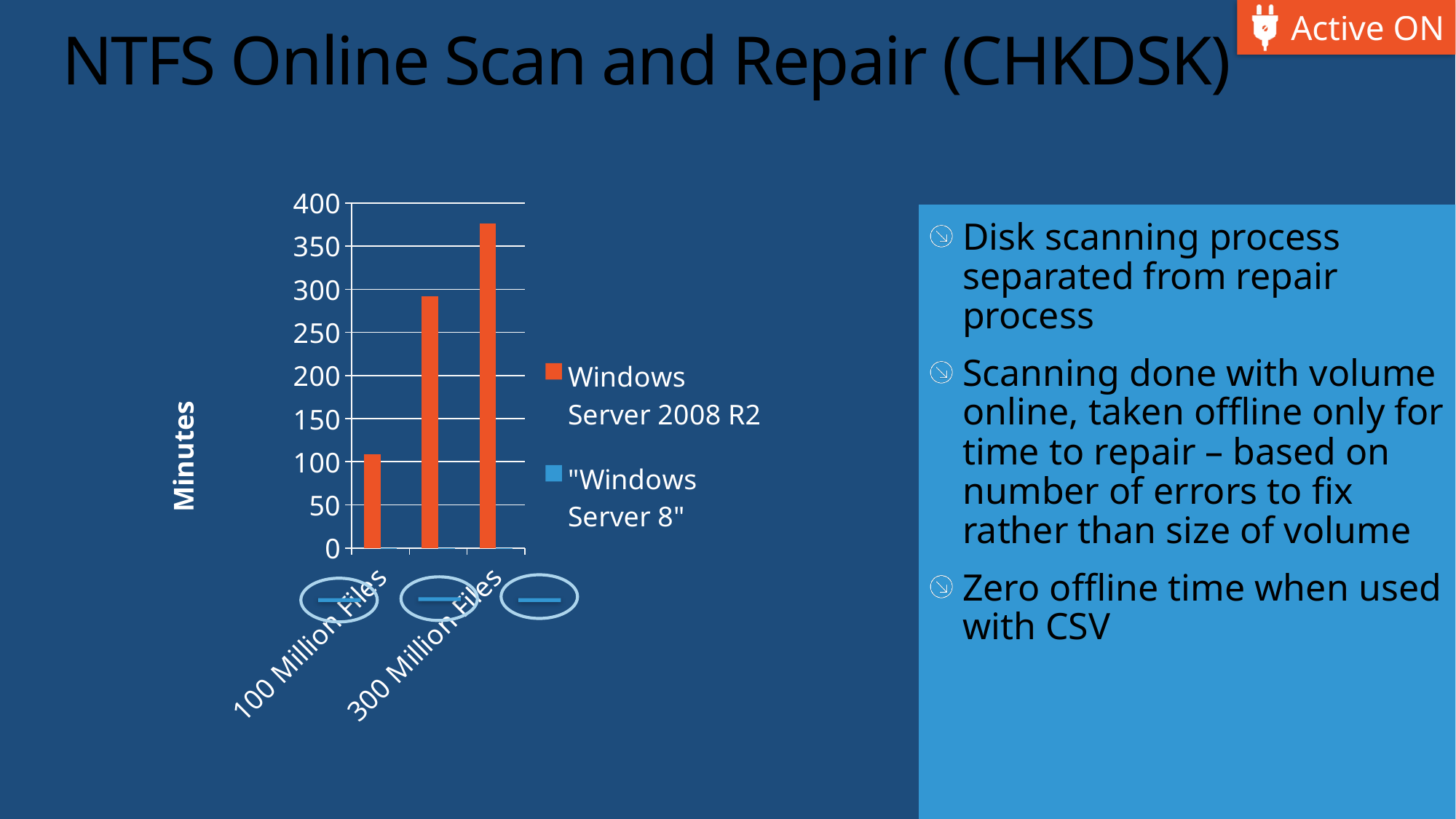
Is the Windows Server 2008 R2 value for 300 Million Files greater or less than 250? greater How many series does the chart legend list? 2 What kind of chart is shown on the slide? bar chart Which series has the taller bar for 300 Million Files, Windows Server 2008 R2 or "Windows Server 8"? Windows Server 2008 R2 Is the Windows Server 2008 R2 value for 100 Million Files greater or less than 100? greater Is the Windows Server 2008 R2 value for 300 Million Files greater or less than 300? greater How many orange Windows Server 2008 R2 bars are plotted on the chart? 3 Do the Windows Server 2008 R2 bars rise or fall from left to right along the x axis? rise What is the label on the vertical axis of the chart? Minutes Which has the larger Windows Server 2008 R2 value, 100 Million Files or 300 Million Files? 300 Million Files What are the two series named in the chart legend? Windows Server 2008 R2 and "Windows Server 8"